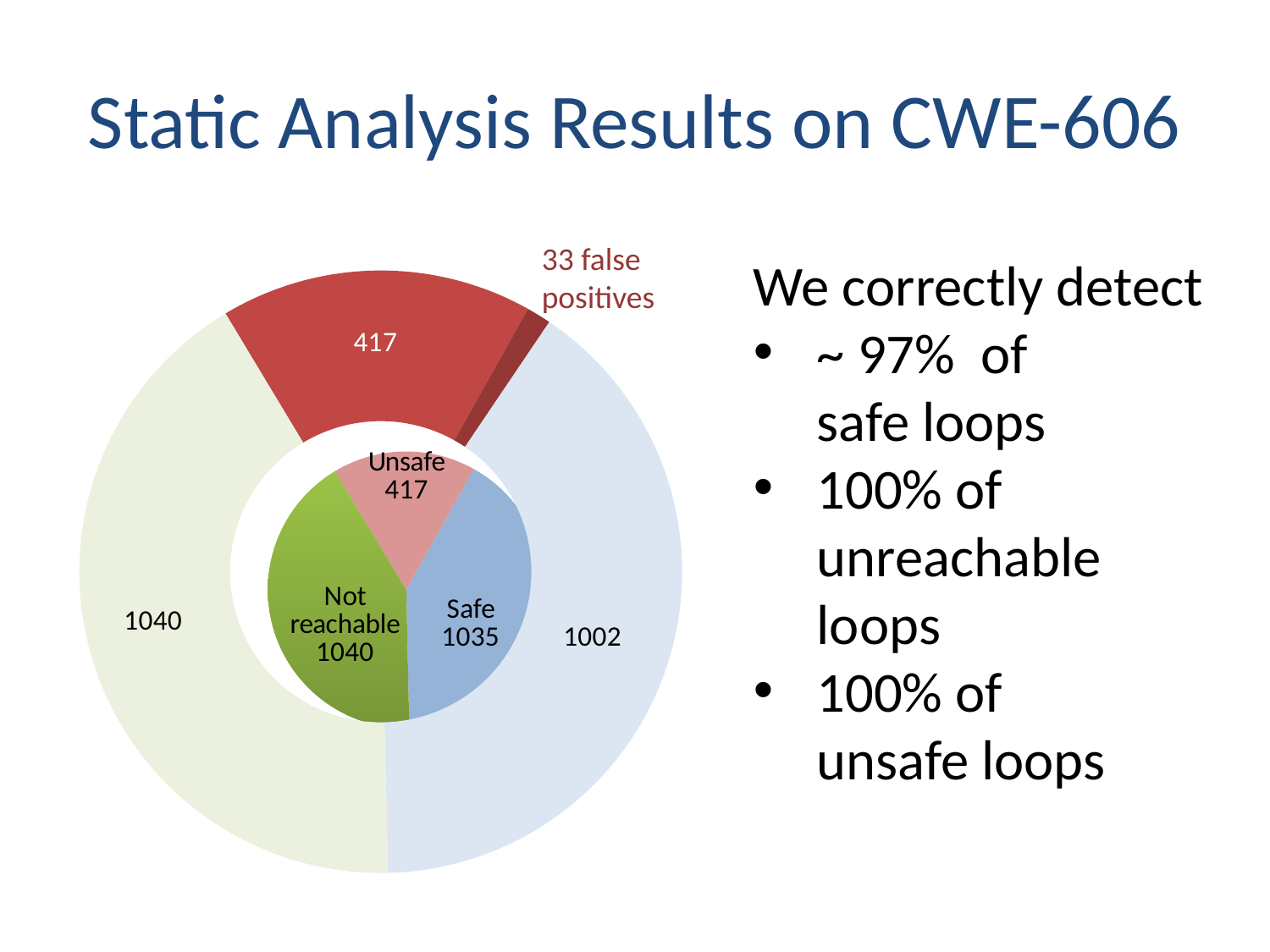
In the outer ring, what value is shown on the light blue segment? 1002 In the inner pie, which slice has the smallest value? Unsafe What is the difference between the Safe value and the Unsafe value in the inner pie? 618 What is the title of the slide containing the chart? Static Analysis Results on CWE-606 In the inner pie, what is the value for the Safe slice? 1035 In the outer ring, how many false positives are labelled? 33 false positives What is the difference between the Not reachable value and the Unsafe value in the inner pie? 623 In the inner pie, what is the value for the Unsafe slice? 417 How many slices does the inner pie have? 3 What is the total of the three inner pie slices (Not reachable, Safe and Unsafe)? 2492 What kind of chart is shown on the slide? pie chart In the inner pie, what is the value for the Not reachable slice? 1040